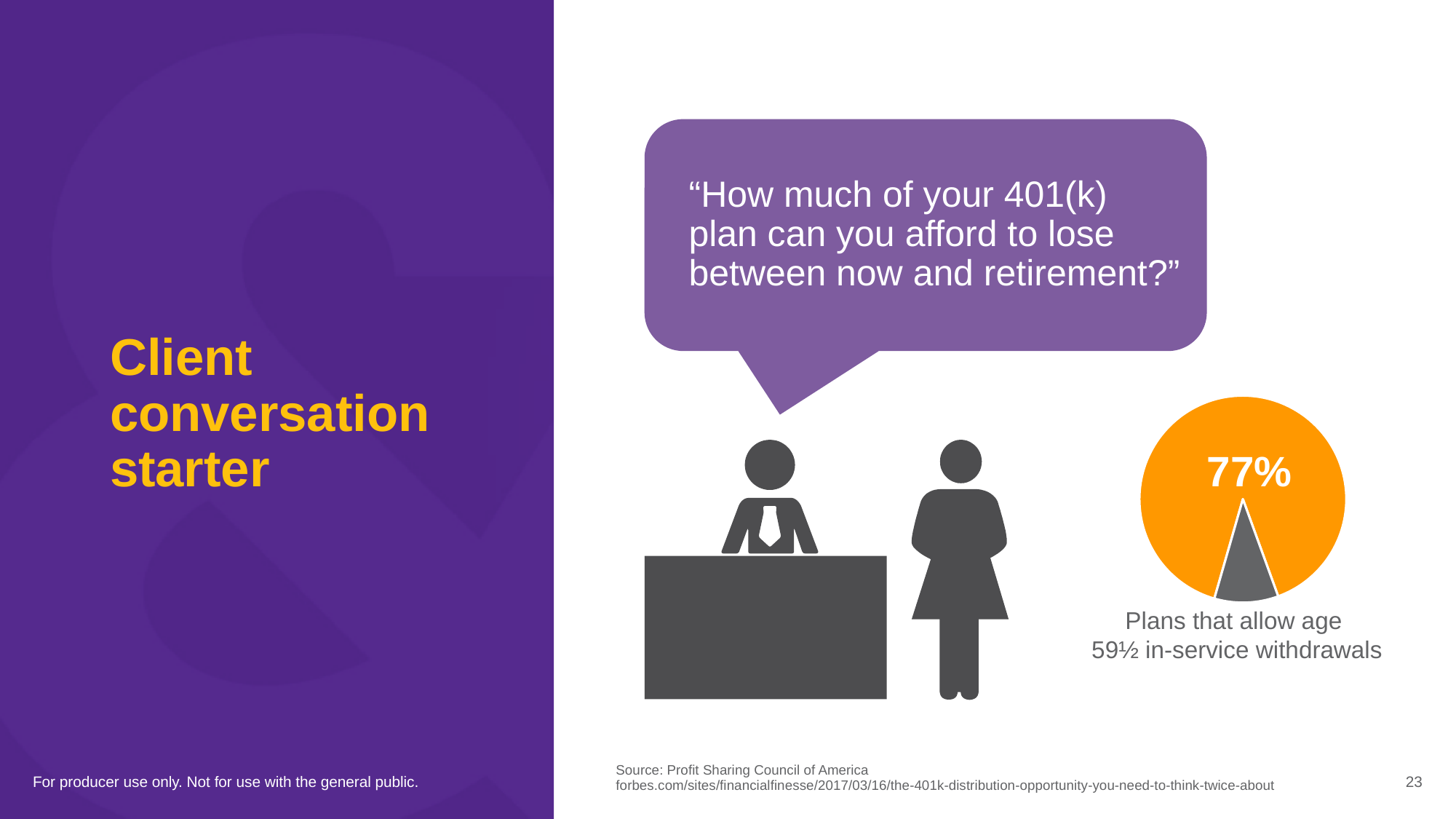
What percentage is printed on the pie chart? 77% What kind of chart is shown on the right side of the slide? Pie chart What does the pie chart's 77% value represent, according to the caption below it? Plans that allow age 59½ in-service withdrawals Which slice of the pie chart is the smallest? The gray slice What share of the pie does the orange slice represent? 77% What colour is the slice of the pie chart labelled 77%? Orange Which slice of the pie chart is larger, the orange slice or the gray slice? The orange slice How many slices does the pie chart have? 2